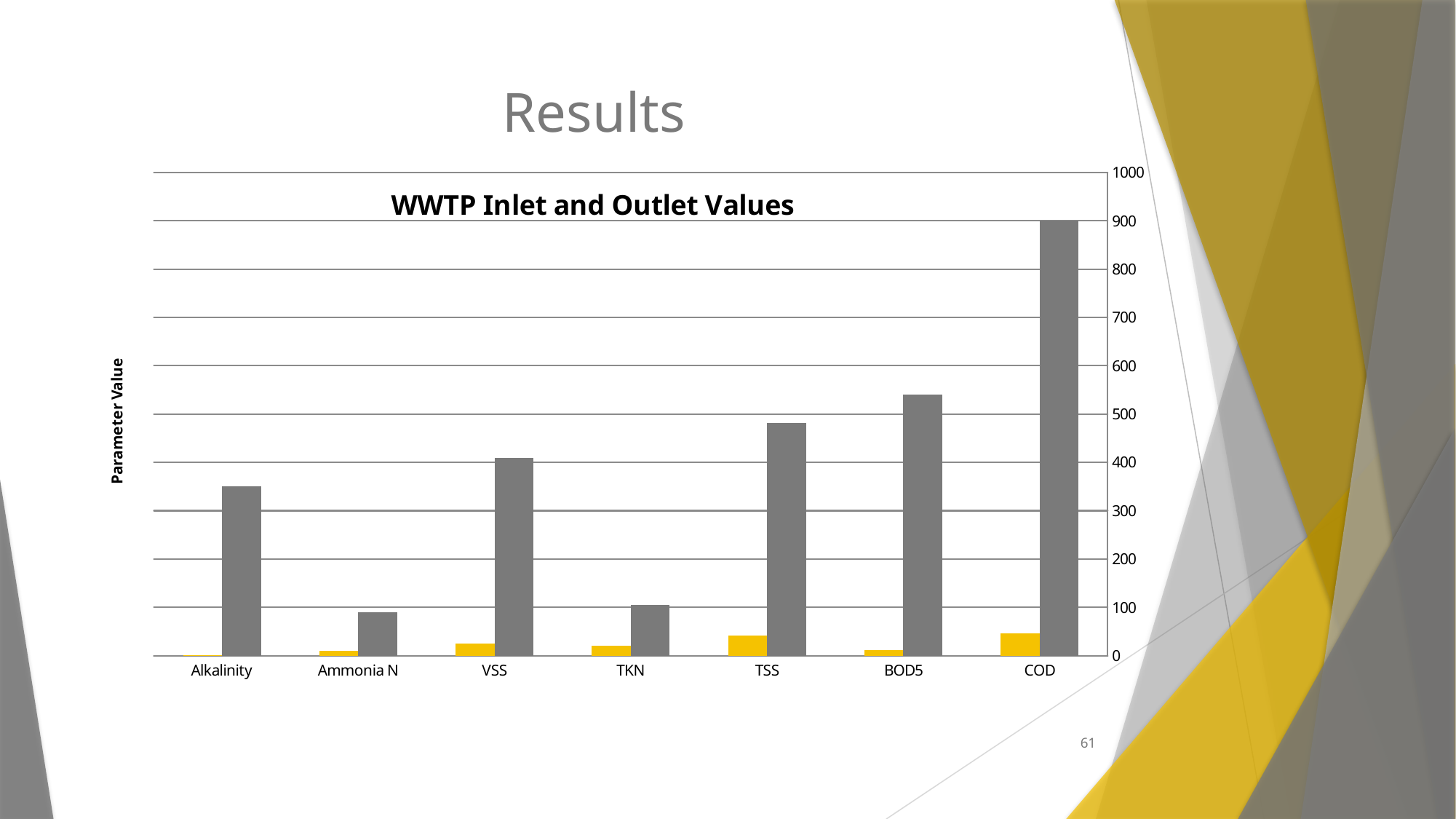
Is the gray bar for TSS greater or less than 500? less Is the gray bar for BOD5 greater or less than 500? greater Which category has the tallest gray bar? COD What kind of chart is shown on the slide? bar chart Is the gray bar for Alkalinity greater or less than 300? greater What is the label on the vertical axis of the chart? Parameter Value How many categories are shown on the x axis of the chart? 7 What is the title of the chart? WWTP Inlet and Outlet Values Which has the larger gray bar, Alkalinity or VSS? VSS Which has the larger gray bar, BOD5 or TSS? BOD5